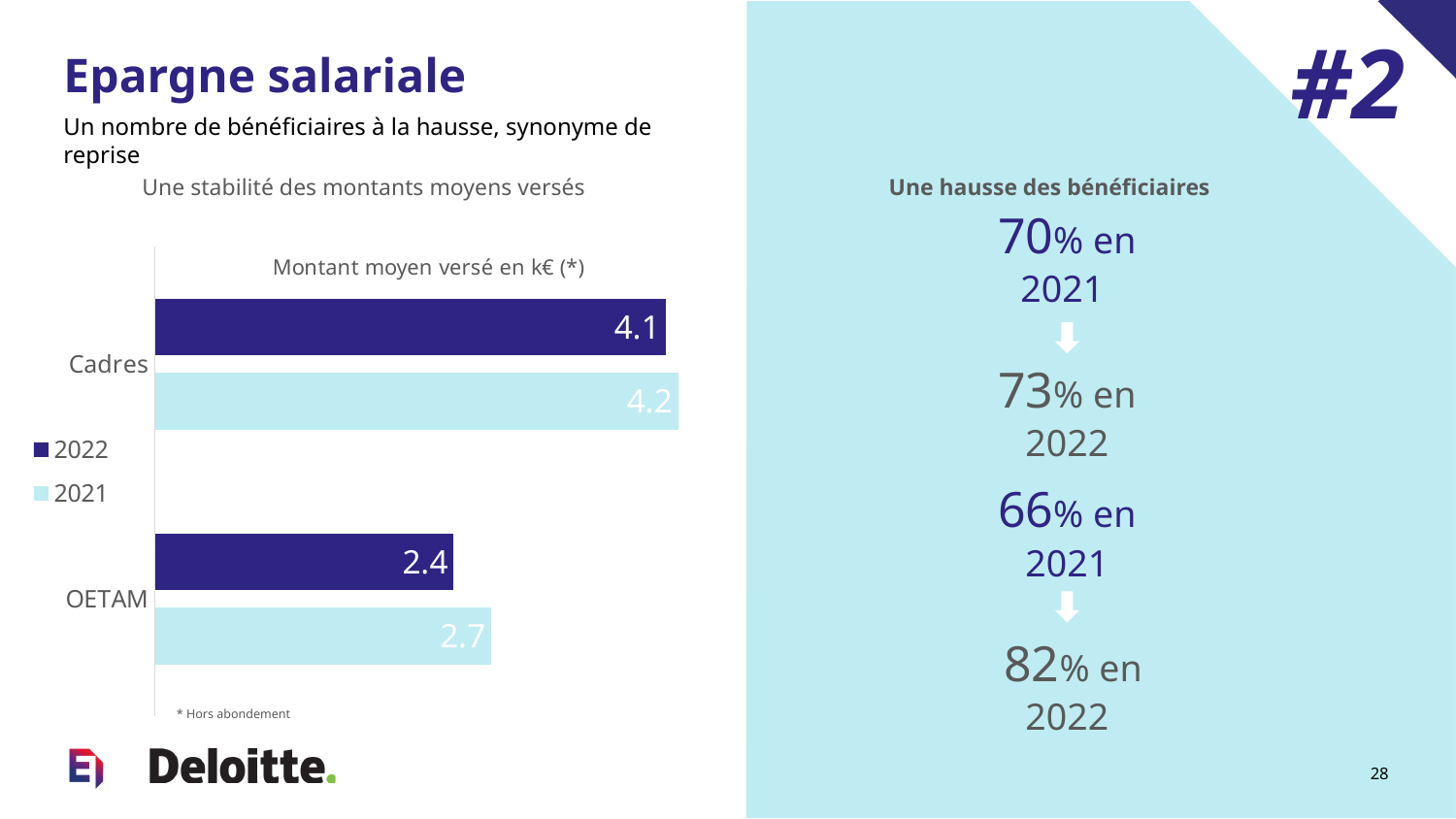
Which is larger for Cadres, the 2022 value or the 2021 value? 2021 What is the title of the chart? Montant moyen versé en k€ (*) How many categories are shown on the chart? 2 What is the value for Cadres in 2021? 4.2 What is the value for Cadres in 2022? 4.1 What is the value for OETAM in 2022? 2.4 What is the difference between the 2021 and 2022 values for OETAM? 0.3 Which category has the lowest value in the 2021 series? OETAM Which category has the highest value in the 2022 series? Cadres What type of chart is shown on the slide? bar chart How many series does the chart legend list? 2 What is the value for OETAM in 2021? 2.7